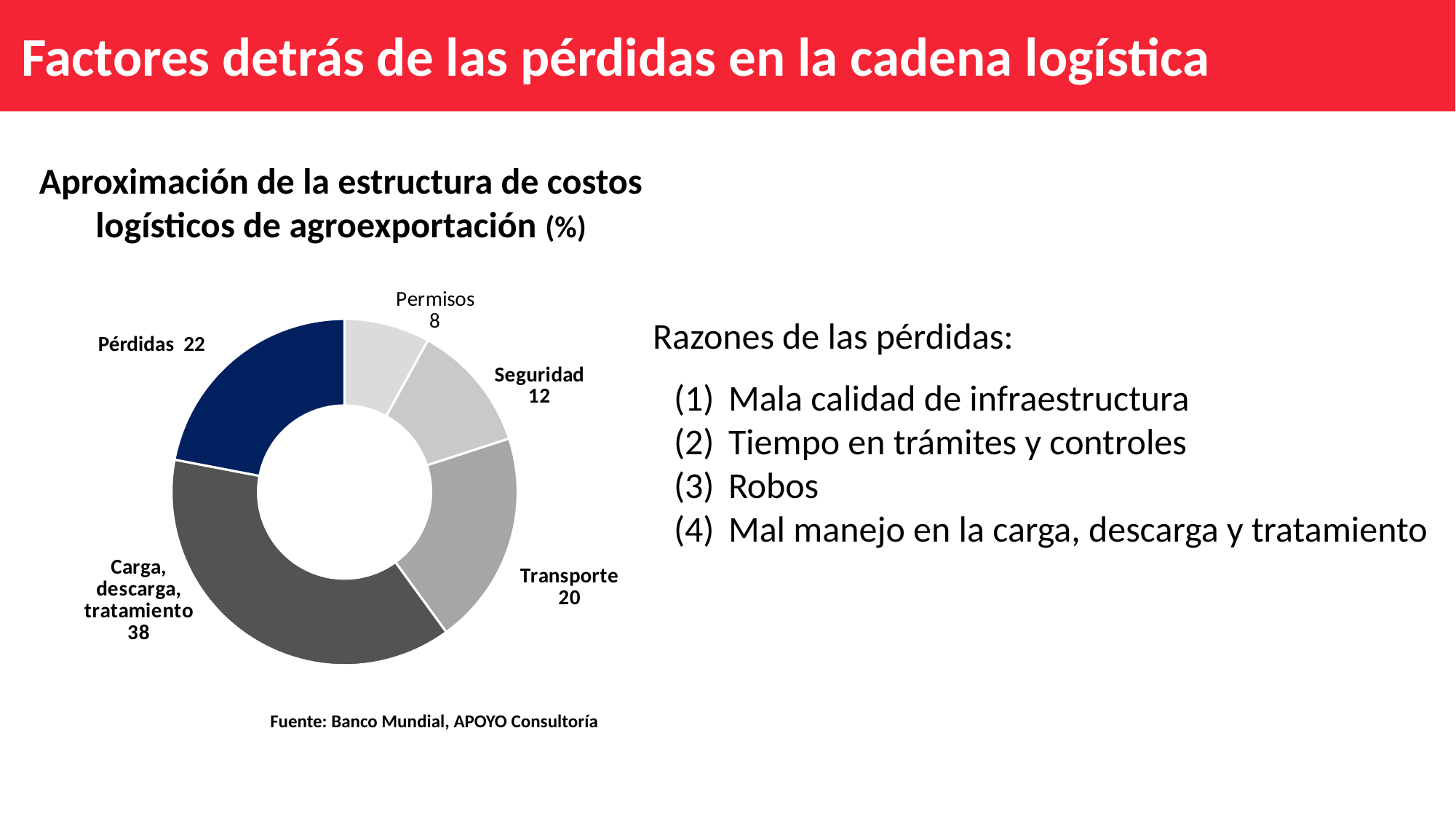
What kind of chart is shown on the slide? Pie chart (doughnut) Which is larger, the value for Transporte or the value for Seguridad? Transporte Which category has the smallest share of the chart? Permisos What is the difference between the values for Carga, descarga, tratamiento and Pérdidas? 16 What value is shown for Seguridad in the chart? 12 How many categories are shown in the chart? 5 What value is shown for Permisos in the chart? 8 What is the title of the chart? Aproximación de la estructura de costos logísticos de agroexportación (%) What value is shown for Pérdidas in the chart? 22 What colour is the Pérdidas slice in the chart? Dark blue Which category has the largest share of the chart? Carga, descarga, tratamiento What value is shown for Transporte in the chart? 20